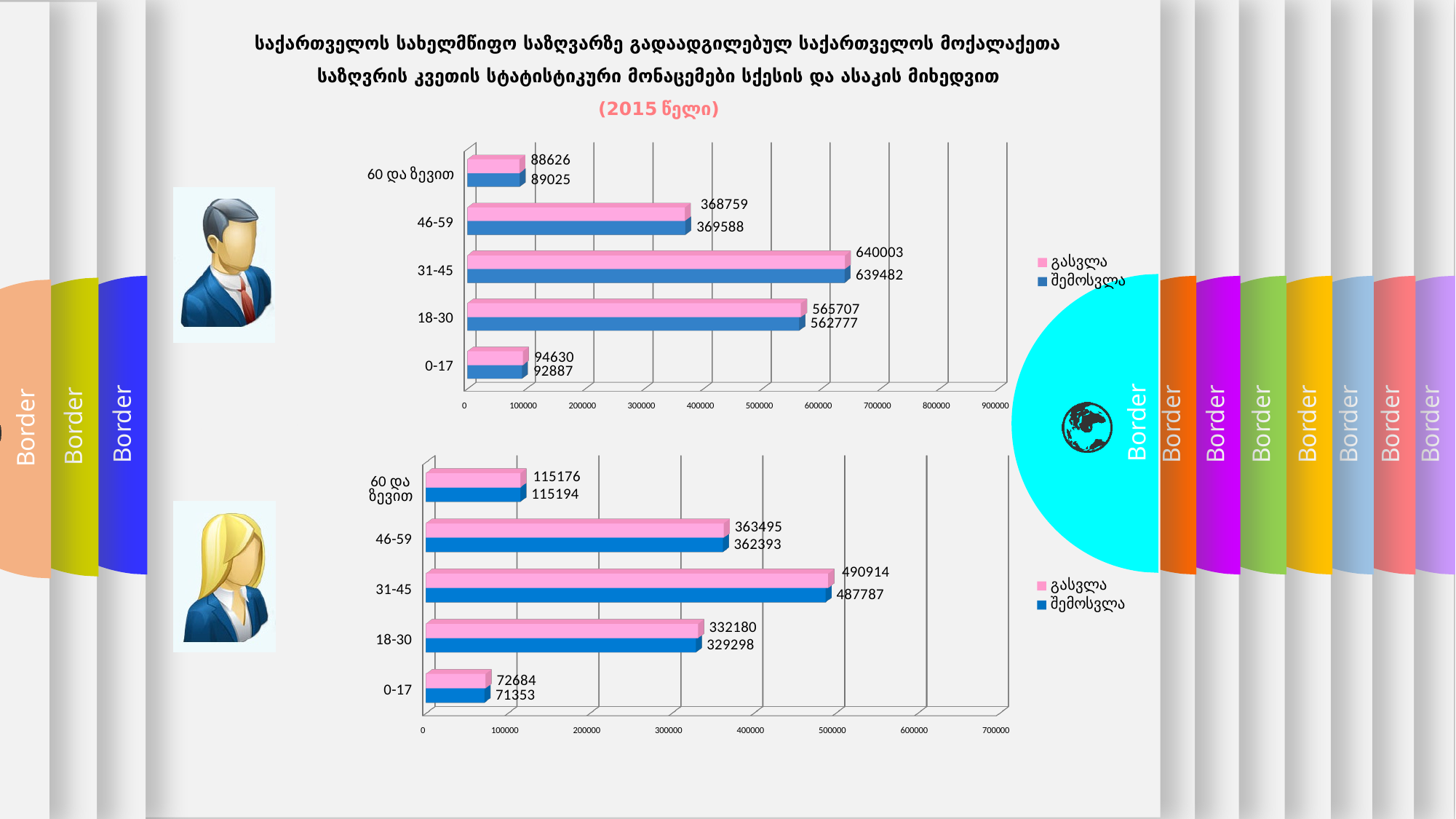
How many series does the legend of the top chart list? 2 In the bottom chart, which age group has the lowest შემოსვლა value? 0-17 In the top chart, which age group has the highest გასვლა value? 31-45 In the top chart, is the შემოსვლა value for the 46-59 age group greater or less than 400000? less In the top chart, which colour represents the შემოსვლა series? blue What type of chart is the bottom chart? bar chart In the bottom chart, what is the გასვლა value for the 60 და ზევით age group? 115176 In the top chart, what is the გასვლა value for the 31-45 age group? 640003 In the bottom chart, which is larger for the 46-59 age group: გასვლა or შემოსვლა? გასვლა In the bottom chart, what is the შემოსვლა value for the 18-30 age group? 329298 How many age groups are shown in the bottom chart? 5 In the top chart, what is the difference between the გასვლა and შემოსვლა values for the 18-30 age group? 2930